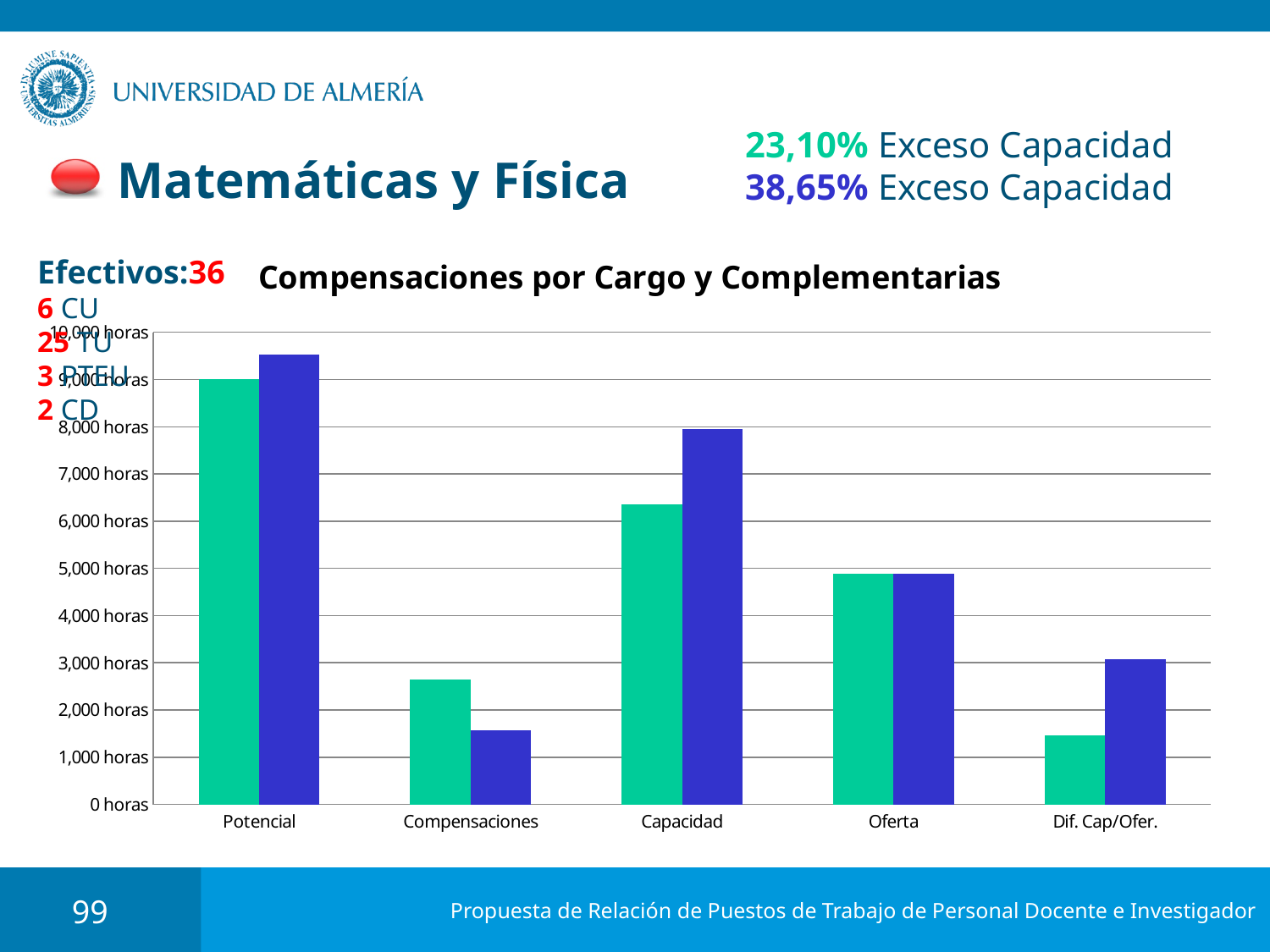
Which category has the lowest blue bar? Compensaciones Is the green bar for Potencial greater or less than 8,000 horas? greater Which category has the lowest green bar? Dif. Cap/Ofer. For Compensaciones, which bar is larger, the green one or the blue one? the green one Is the blue bar for Compensaciones greater or less than 2,000 horas? less Which category has the highest green bar? Potencial Is the green bar for Dif. Cap/Ofer. greater or less than 2,000 horas? less How many categories are shown on the x axis of the chart? 5 What is the title of the chart? Compensaciones por Cargo y Complementarias For Capacidad, which bar is larger, the green one or the blue one? the blue one What kind of chart is shown on the slide? bar chart